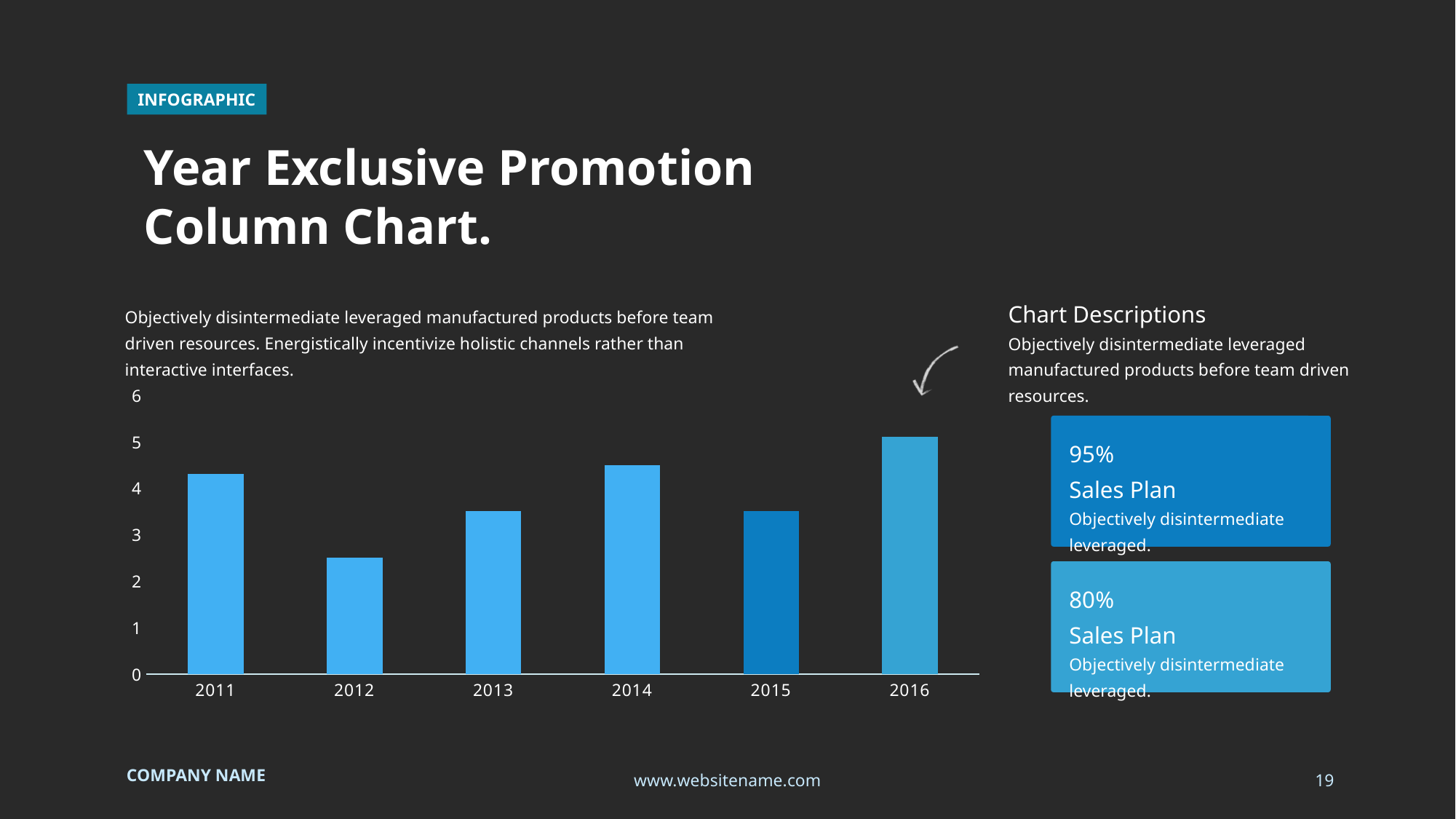
Which is larger, the value for 2016 or the value for 2014? 2016 Does the value rise or fall from 2011 to 2012? fall Is the value for 2011 greater or less than 4? greater Which year has the lowest bar in the chart? 2012 Which is larger, the value for 2011 or the value for 2012? 2011 How many years are shown on the x axis of the chart? 6 Is the value for 2014 greater or less than 5? less Which year has the highest bar in the chart? 2016 What kind of chart is shown on the slide? bar chart What is the highest value shown on the chart's vertical axis? 6 Is the value for 2012 greater or less than 3? less